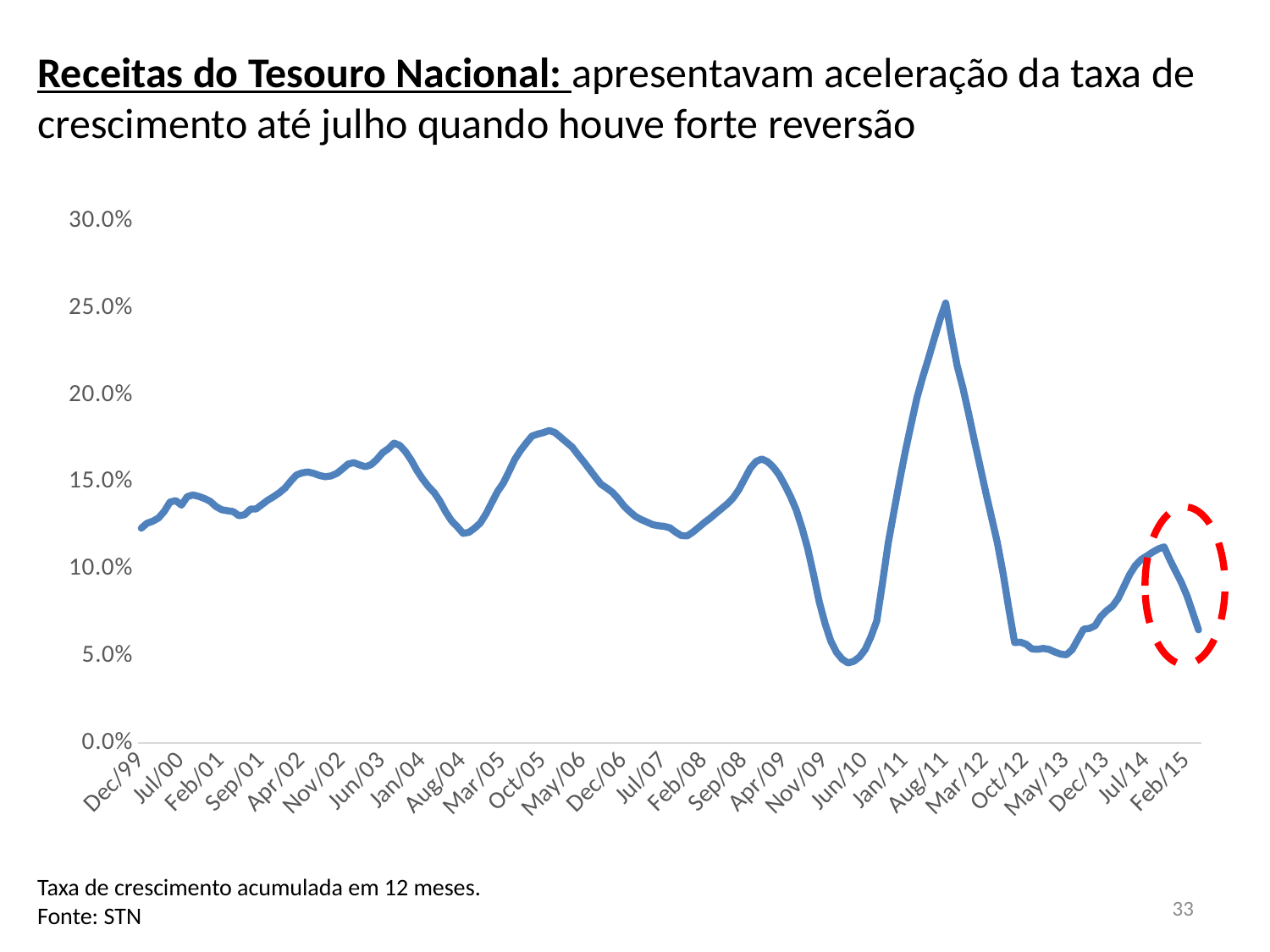
Which is larger, the value at Aug/11 or the value at Jun/03? Aug/11 Is the value at Aug/11 greater or less than 20.0%? greater What kind of chart is shown on the slide? line chart Does the line rise or fall between Jul/14 and Feb/15? fall Which labeled point on the x axis has the highest value? Aug/11 What source is cited for the chart? STN Which labeled point on the x axis has the lowest value? May/13 Is the value at Oct/05 greater or less than 15.0%? greater Is the value at Oct/12 greater or less than 10.0%? less How many labels are shown on the x axis? 27